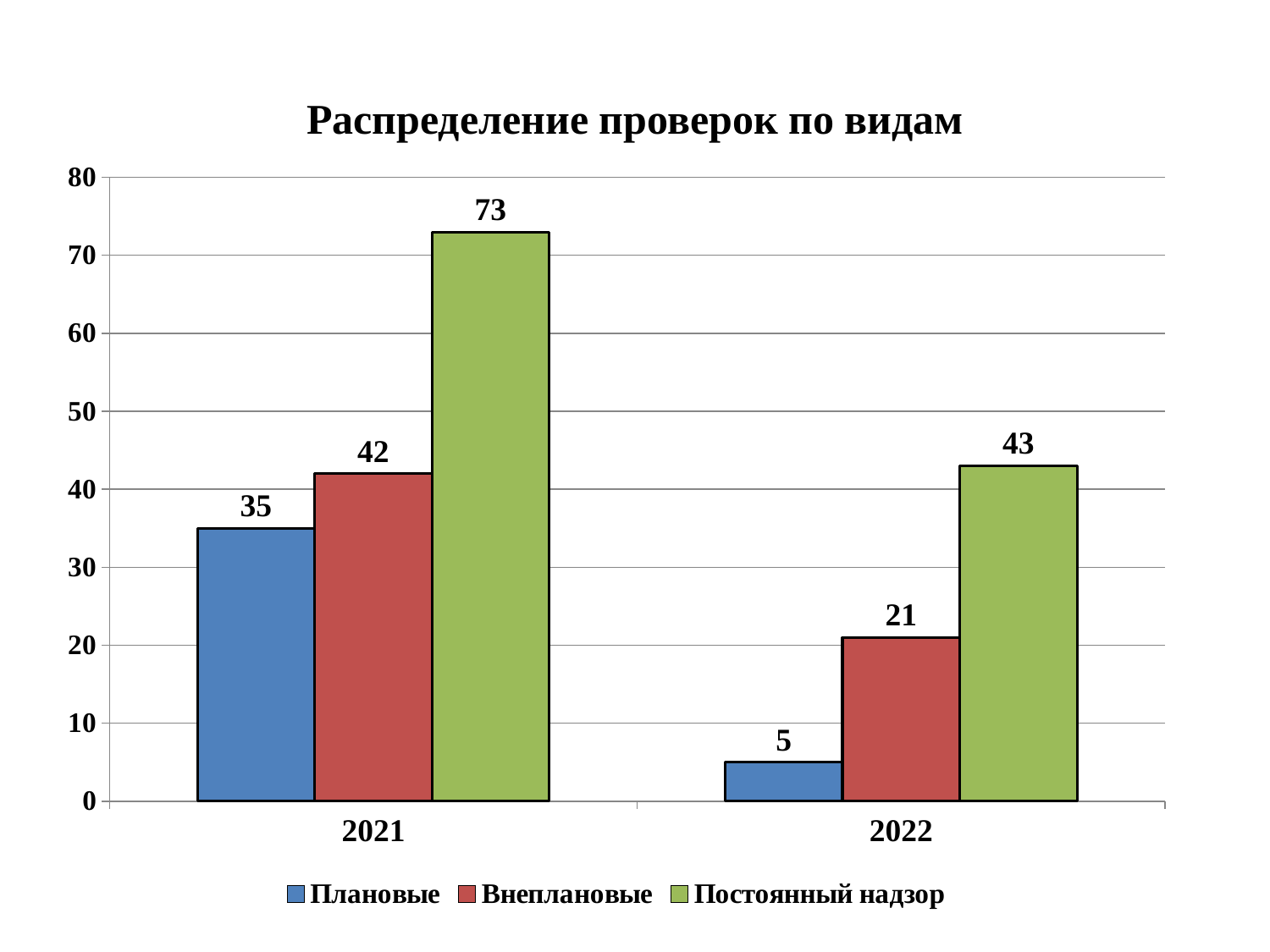
What is the value for Внеплановые in 2022? 21 Which is larger: Внеплановые in 2021 or Плановые in 2021? Внеплановые in 2021 How many series does the legend list? 3 What is the value for Постоянный надзор in 2022? 43 What is the value for Плановые in 2021? 35 What is the difference between Постоянный надзор in 2021 and in 2022? 30 Which series has the highest value in 2021? Постоянный надзор What kind of chart is shown on the slide? Bar chart What is the title of the chart? Распределение проверок по видам Which series has the lowest value in 2022? Плановые Do the values for Плановые rise or fall from 2021 to 2022? Fall How many categories are shown on the x axis? 2